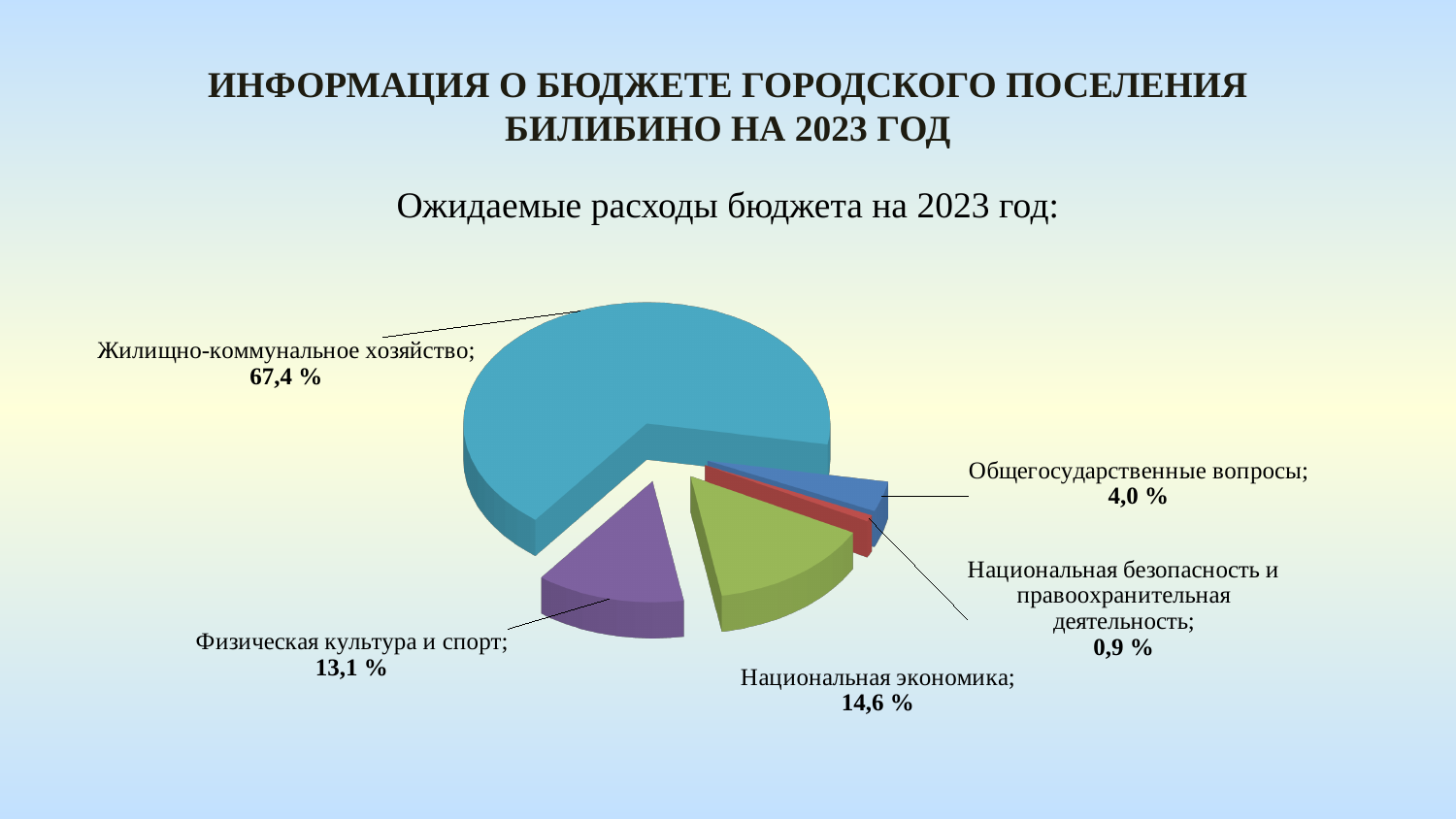
What is the difference between Общегосударственные вопросы and Национальная безопасность и правоохранительная деятельность? 3,1 % What is the difference between Национальная экономика and Физическая культура и спорт? 1,5 % What kind of chart is shown on the slide? Pie chart How many slices does the pie chart have? 5 What is the value shown for Национальная экономика? 14,6 % Which category has the smallest share of the pie? Национальная безопасность и правоохранительная деятельность Which is larger: Национальная экономика or Физическая культура и спорт? Национальная экономика What is the value shown for Физическая культура и спорт? 13,1 % What share of the pie is Жилищно-коммунальное хозяйство? 67,4 % What is the value shown for Национальная безопасность и правоохранительная деятельность? 0,9 % What is the value shown for Общегосударственные вопросы? 4,0 % Which category has the largest share of the pie? Жилищно-коммунальное хозяйство